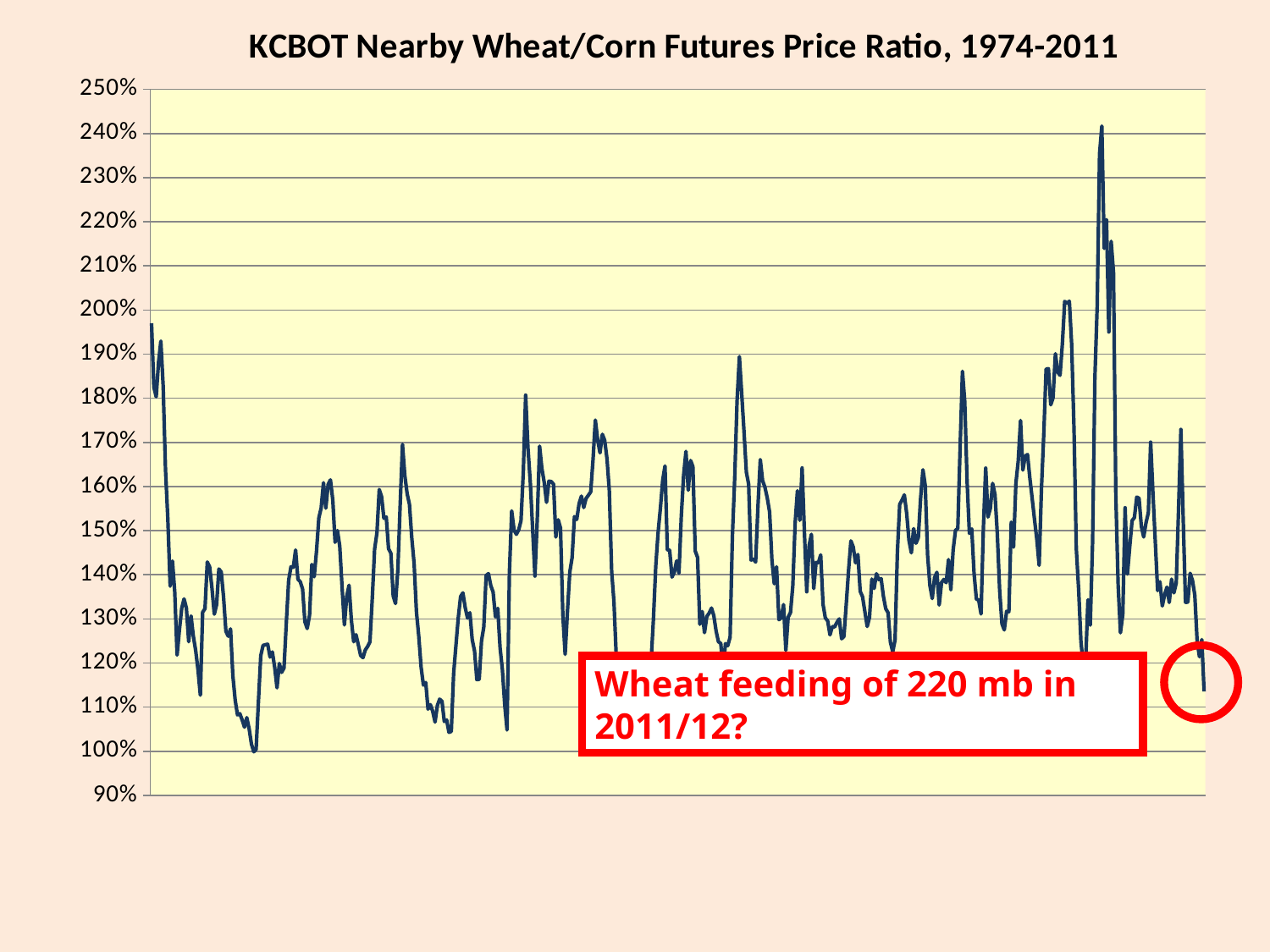
What is the highest value shown on the vertical axis? 250% How many data series are plotted on the chart? 1 What kind of chart is shown on the slide? line chart Is the lowest point of the wheat/corn price ratio line greater or less than 110%? less What is the title of the chart? KCBOT Nearby Wheat/Corn Futures Price Ratio, 1974-2011 Is the final (circled) value at the right end of the line greater or less than 120%? less Is the highest peak of the line greater or less than 200%? greater What years does the chart title say the data covers? 1974-2011